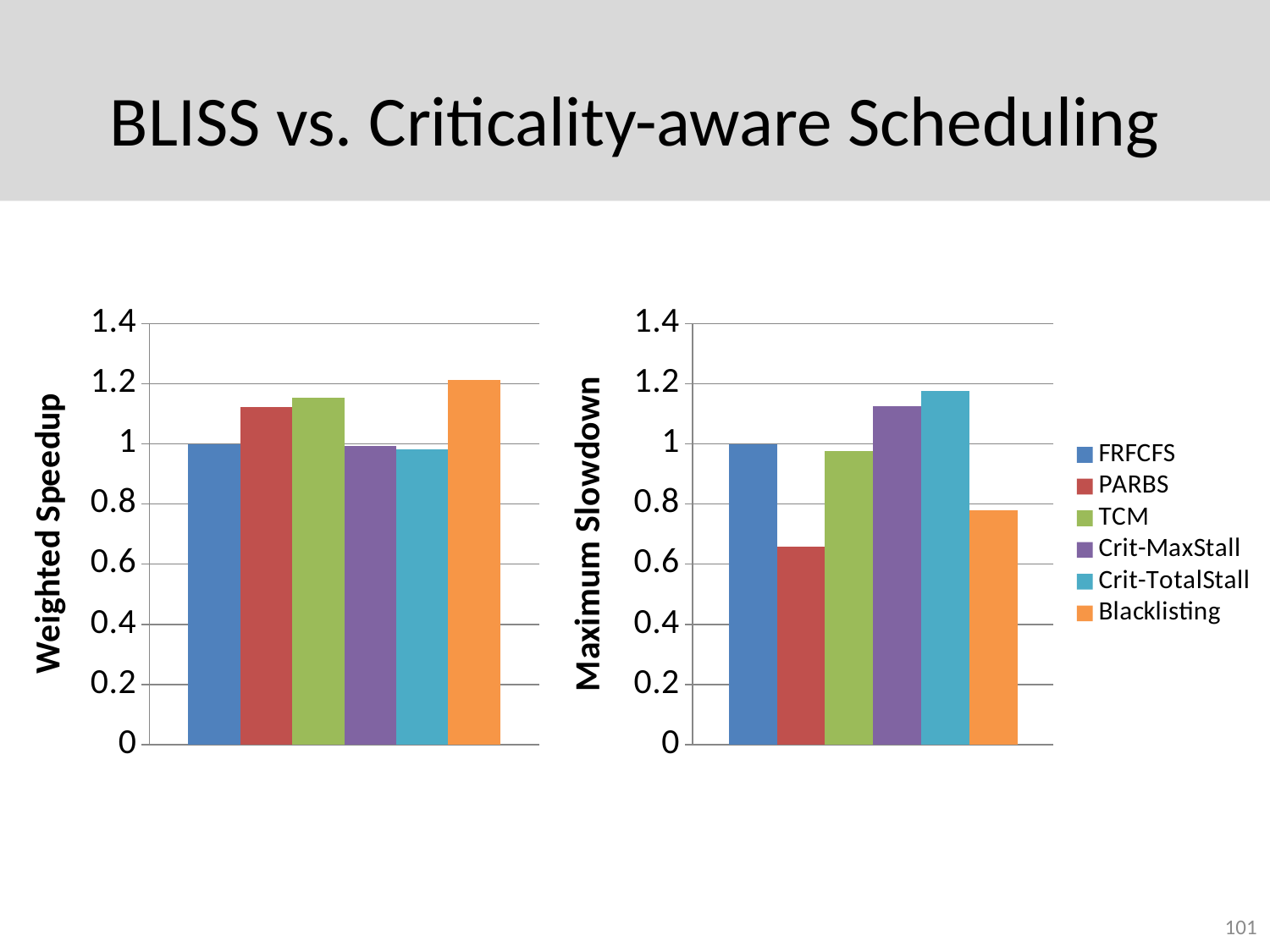
What is the y-axis title of the chart on the right? Maximum Slowdown In the Maximum Slowdown chart, which series has the lowest value? PARBS In the Weighted Speedup chart, which is larger, the value for FRFCFS or the value for Blacklisting? Blacklisting In the Weighted Speedup chart, is the value for Blacklisting greater or less than 1? greater What kind of chart is the Weighted Speedup chart on the left? Bar chart In the Maximum Slowdown chart, which series has the highest value? Crit-TotalStall In the Maximum Slowdown chart, is the value for PARBS greater or less than 0.8? less In the Maximum Slowdown chart, is the value for Crit-TotalStall greater or less than 1? greater How many series does the legend list? 6 In the Maximum Slowdown chart, which is larger, the value for PARBS or the value for Blacklisting? Blacklisting In the Weighted Speedup chart, which series has the highest value? Blacklisting In the Weighted Speedup chart, what is the value for FRFCFS? 1